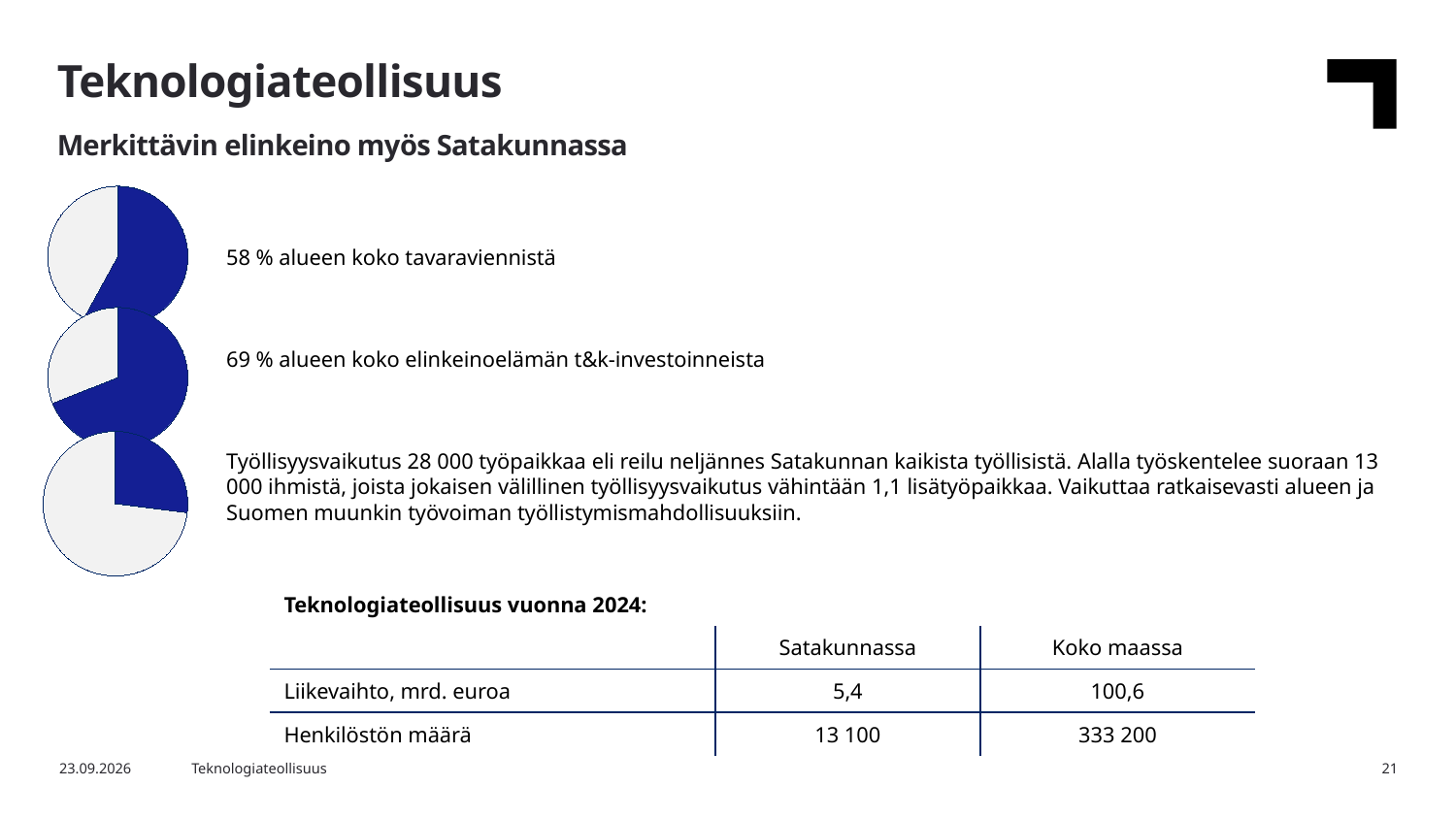
Which of the three pie charts has the largest blue slice? The middle pie chart (69 %) What is the difference in percentage points between the shares shown for the middle pie chart (69 %) and the top pie chart (58 %)? 11 percentage points According to the text next to the top pie chart, what share of the region's total goods exports does the technology industry account for? 58 % What is the title of the slide that the pie charts appear on? Teknologiateollisuus Which of the three pie charts has the smallest blue slice? The bottom pie chart Is the blue slice larger in the top pie chart or in the middle pie chart? The middle pie chart Is the blue slice of the bottom pie chart greater or less than half of the pie? less According to the text next to the middle pie chart, what share of the region's business R&D investments does the technology industry account for? 69 % How many pie charts are on the slide? 3 What kind of chart is shown on the left side of the slide? Pie chart Is the blue slice of the middle pie chart greater or less than half of the pie? greater What colour is used for the highlighted slice in each pie chart? Blue